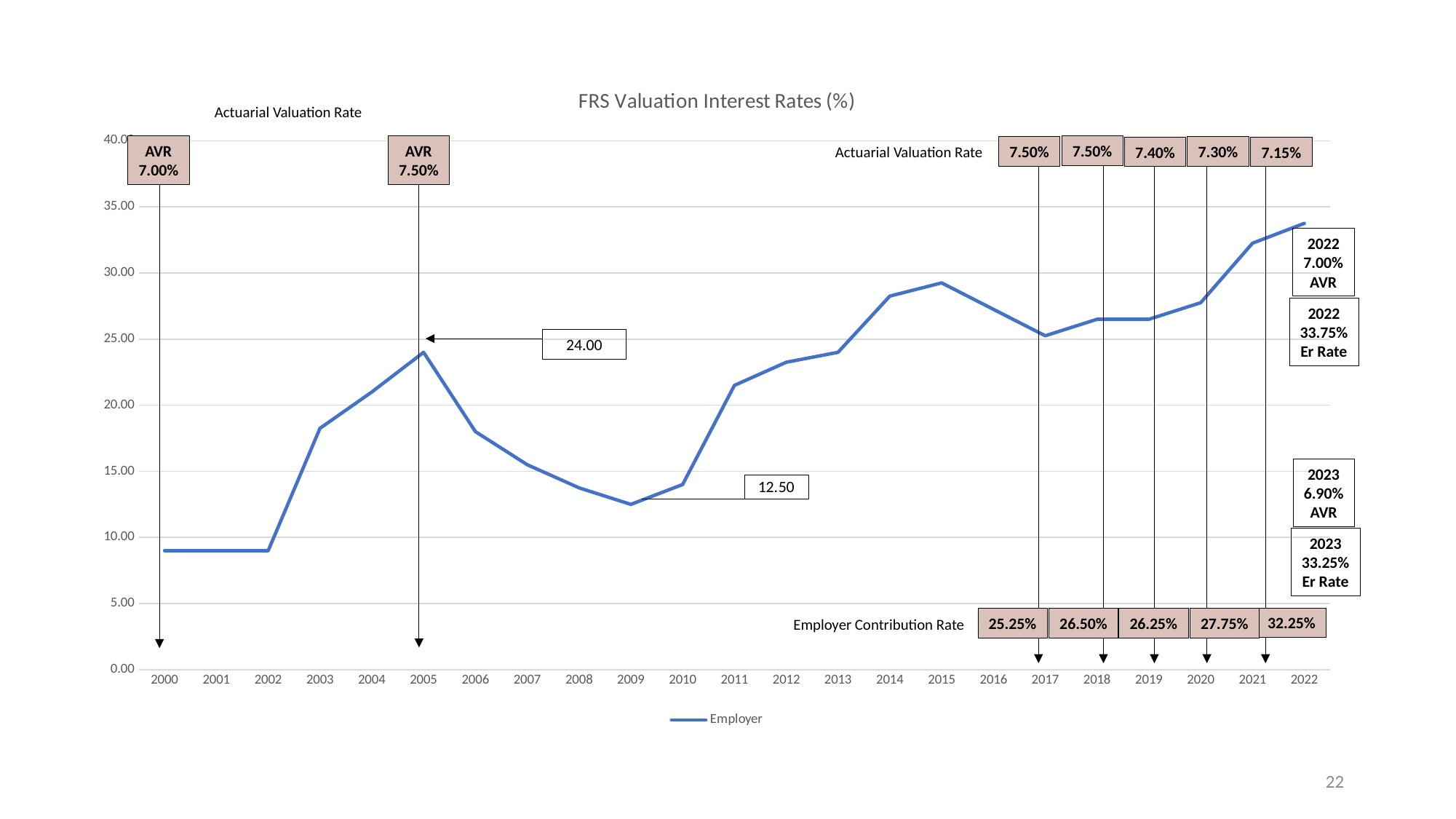
What value is labelled for the Employer line at its 2005 peak? 24.00 Between 2005 and 2015, which year has the lowest Employer value? 2009 How many series does the legend list? 1 How many years are plotted along the x axis? 23 What value is labelled for the Employer line in 2009? 12.50 Does the Employer line rise or fall from 2005 to 2009? fall What kind of chart is shown on the slide? line chart Is the Employer value for 2000 greater or less than 10.00? less Which year has the highest Employer value on the chart? 2022 Which is larger, the Employer value in 2005 or in 2015? 2015 What is the difference between the labelled 2005 value and the labelled 2009 value? 11.50 What Employer Contribution Rate is shown in the box for 2021? 32.25%